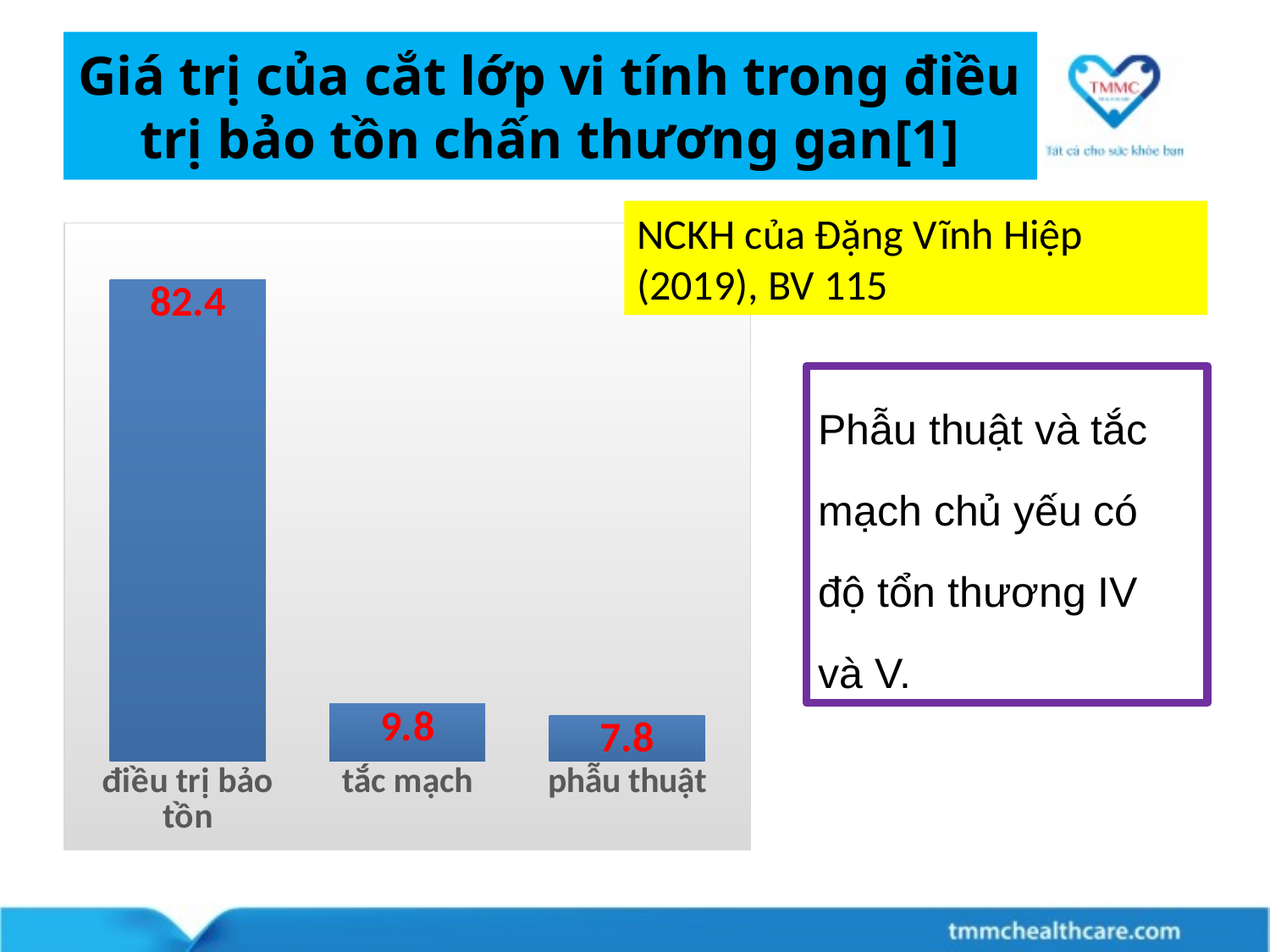
What kind of chart is shown on the slide? bar chart What is the difference between the values for "điều trị bảo tồn" and "tắc mạch"? 72.6 What is the value for "phẫu thuật"? 7.8 What is the value for "điều trị bảo tồn"? 82.4 Which category has the highest value? điều trị bảo tồn What colour are the bars in the chart? blue Do the values rise or fall from left to right across the categories? fall What is the difference between the values for "tắc mạch" and "phẫu thuật"? 2.0 Which is larger, the value for "tắc mạch" or the value for "phẫu thuật"? tắc mạch How many categories are shown in the chart? 3 Which category has the lowest value? phẫu thuật What is the value for "tắc mạch"? 9.8